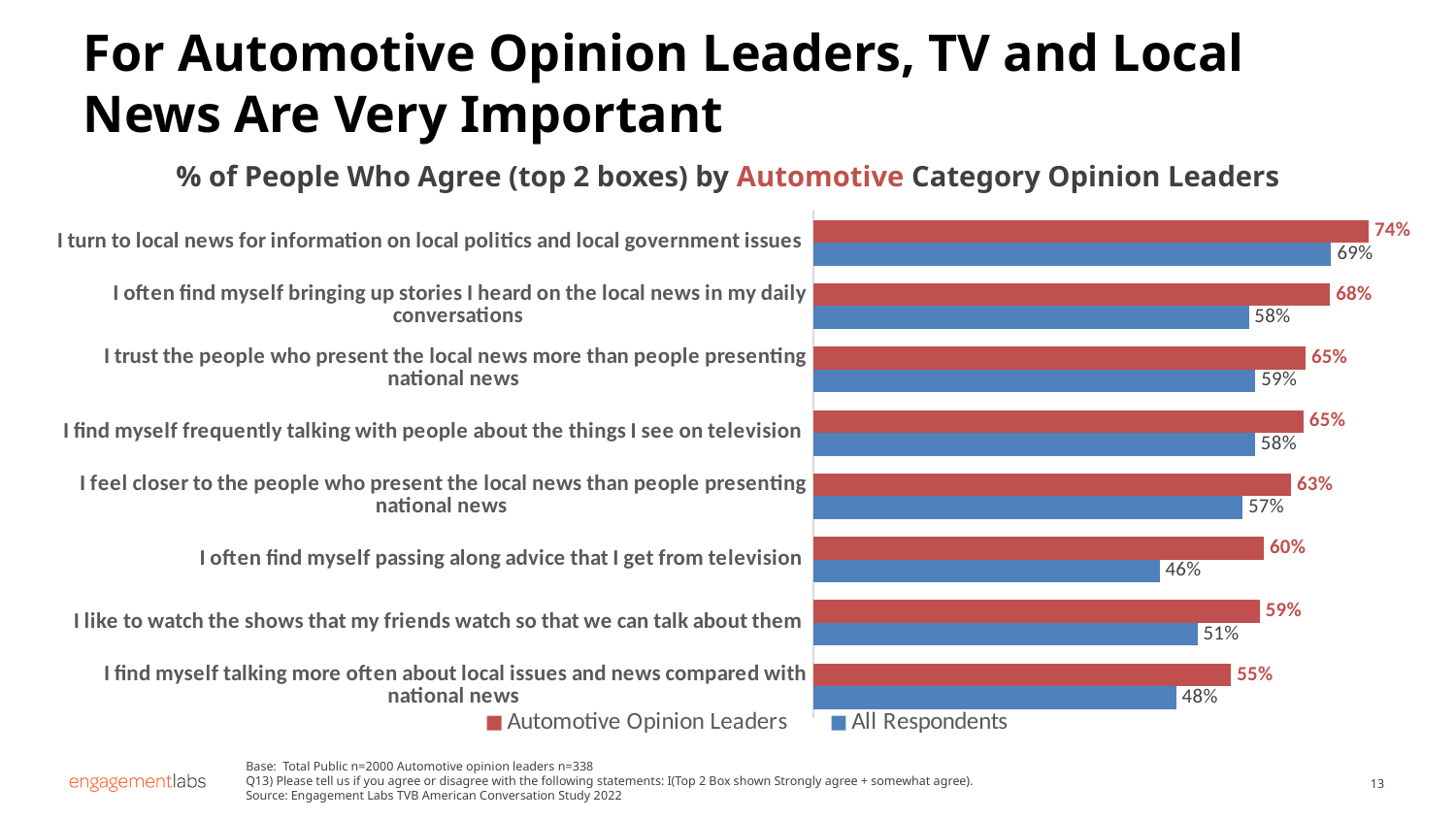
What type of chart is shown on the slide? Bar chart What percentage of All Respondents agree with "I often find myself passing along advice that I get from television"? 46% Which colour represents Automotive Opinion Leaders in the chart? Red Which statement has the highest agreement among Automotive Opinion Leaders? I turn to local news for information on local politics and local government issues What percentage of All Respondents agree with "I like to watch the shows that my friends watch so that we can talk about them"? 51% For "I trust the people who present the local news more than people presenting national news", which group has the higher agreement: Automotive Opinion Leaders or All Respondents? Automotive Opinion Leaders What percentage of Automotive Opinion Leaders agree with "I turn to local news for information on local politics and local government issues"? 74% What is the difference between Automotive Opinion Leaders and All Respondents for "I often find myself passing along advice that I get from television"? 14 percentage points How many statements are shown in the chart? 8 Which statement has the lowest agreement among All Respondents? I often find myself passing along advice that I get from television How many series does the legend list? 2 What is the difference between Automotive Opinion Leaders and All Respondents for "I find myself talking more often about local issues and news compared with national news"? 7 percentage points